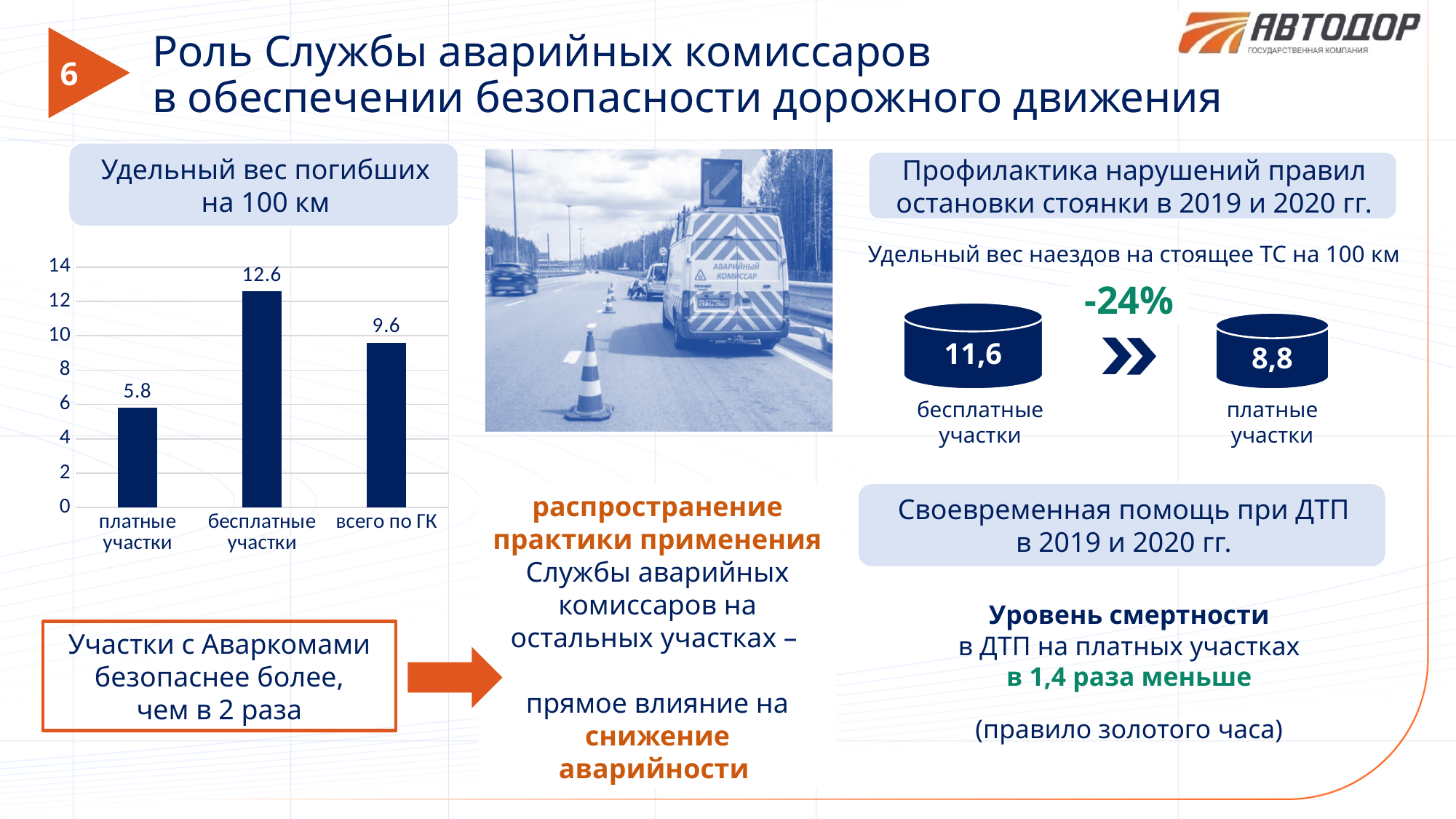
What is the value for «бесплатные участки» in the chart «Удельный вес погибших на 100 км»? 12.6 In the chart «Удельный вес погибших на 100 км», is the value for «бесплатные участки» greater or less than 10? greater What type of chart is «Удельный вес погибших на 100 км»? bar chart In the chart «Удельный вес погибших на 100 км», which is larger: «всего по ГК» or «платные участки»? всего по ГК Which category has the lowest value in the chart «Удельный вес погибших на 100 км»? платные участки What is the value for «всего по ГК» in the chart «Удельный вес погибших на 100 км»? 9.6 How many categories are shown in the chart «Удельный вес погибших на 100 км»? 3 In the chart «Удельный вес погибших на 100 км», what is the difference between «всего по ГК» and «платные участки»? 3.8 In the chart «Удельный вес погибших на 100 км», what is the difference between «бесплатные участки» and «платные участки»? 6.8 What is the value for «платные участки» in the chart «Удельный вес погибших на 100 км»? 5.8 Which category has the highest value in the chart «Удельный вес погибших на 100 км»? бесплатные участки What is the maximum value shown on the vertical axis of the chart «Удельный вес погибших на 100 км»? 14